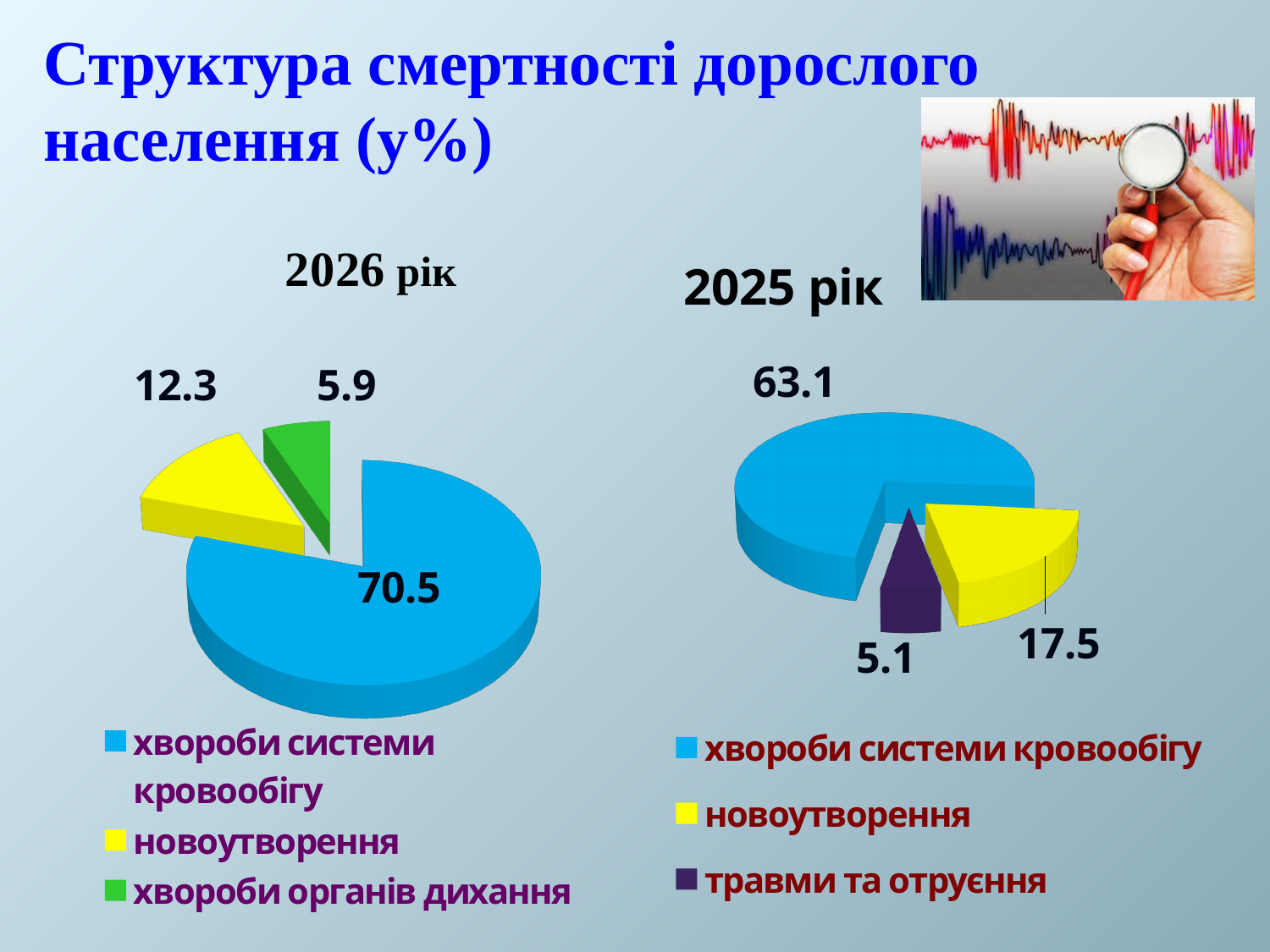
In the "2026 рік" chart, which category has the smallest slice? хвороби органів дихання In the "2026 рік" chart, what is the value for хвороби системи кровообігу? 70.5 In the "2025 рік" chart, what is the value for травми та отруєння? 5.1 In the "2025 рік" chart, what is the difference between the values for хвороби системи кровообігу and новоутворення? 45.6 In the "2026 рік" chart, what is the value for хвороби органів дихання? 5.9 In the "2025 рік" chart, which category has the largest slice? хвороби системи кровообігу Which is larger: the value for новоутворення in the "2026 рік" chart or in the "2025 рік" chart? 2025 рік In the "2025 рік" chart, what colour is the slice for травми та отруєння? purple What type of chart is the "2026 рік" chart? pie chart In the "2025 рік" chart, what is the value for хвороби системи кровообігу? 63.1 In the "2026 рік" chart, what is the value for новоутворення? 12.3 How many slices does the "2025 рік" chart have? 3